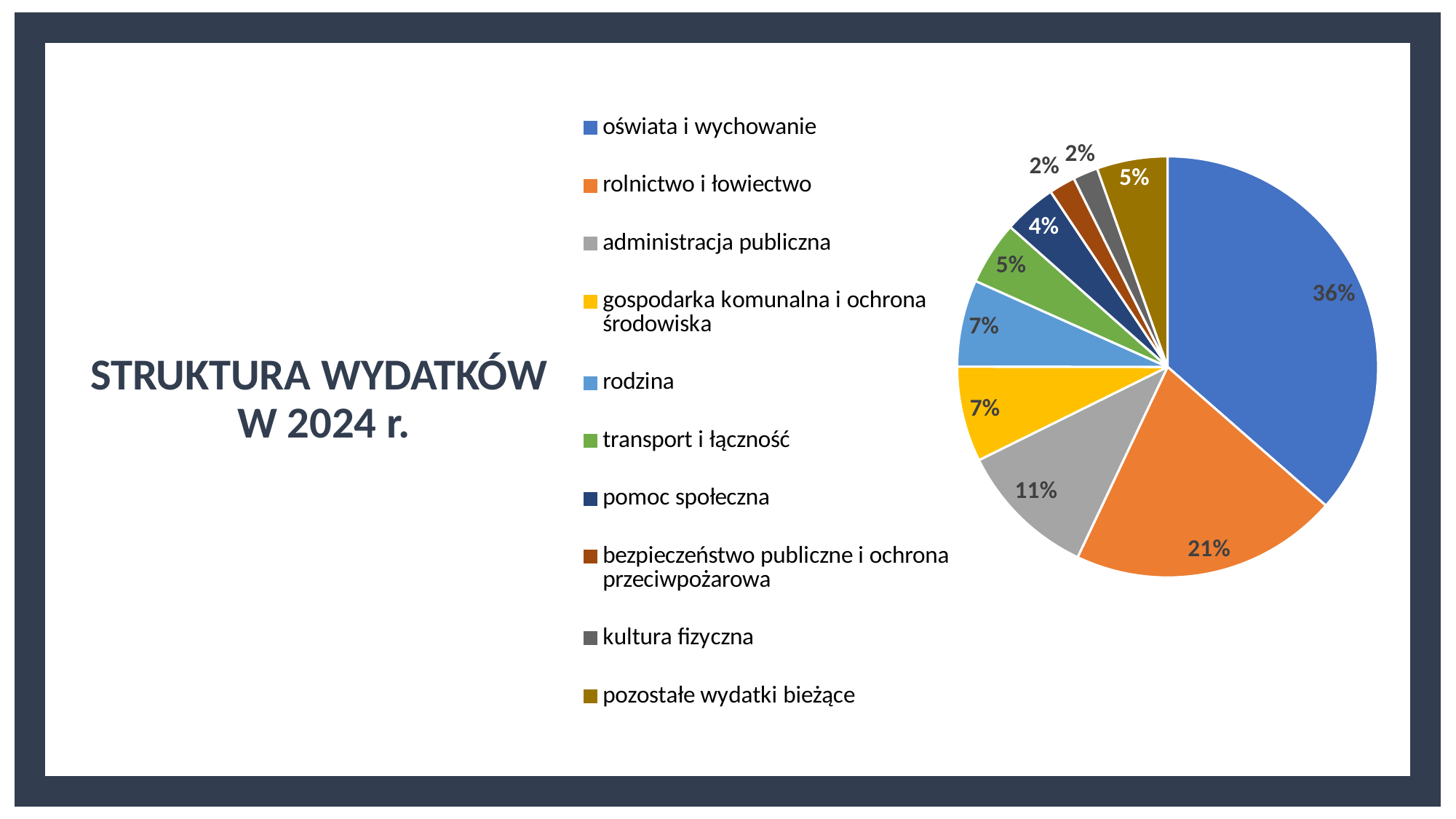
What is the value shown for "rolnictwo i łowiectwo"? 21% What share of the pie does "oświata i wychowanie" take? 36% What is the difference between the shares of "transport i łączność" and "pomoc społeczna"? 1% What is the value shown for "pomoc społeczna"? 4% What colour is the slice for "gospodarka komunalna i ochrona środowiska"? yellow What is the value shown for "administracja publiczna"? 11% How many categories does the pie chart have? 10 Which is larger, the share for "administracja publiczna" or the share for "rodzina"? administracja publiczna What kind of chart is shown on the slide? pie chart What is the difference between the shares of "oświata i wychowanie" and "rolnictwo i łowiectwo"? 15% Which category has the largest slice of the pie? oświata i wychowanie What is the value shown for "pozostałe wydatki bieżące"? 5%